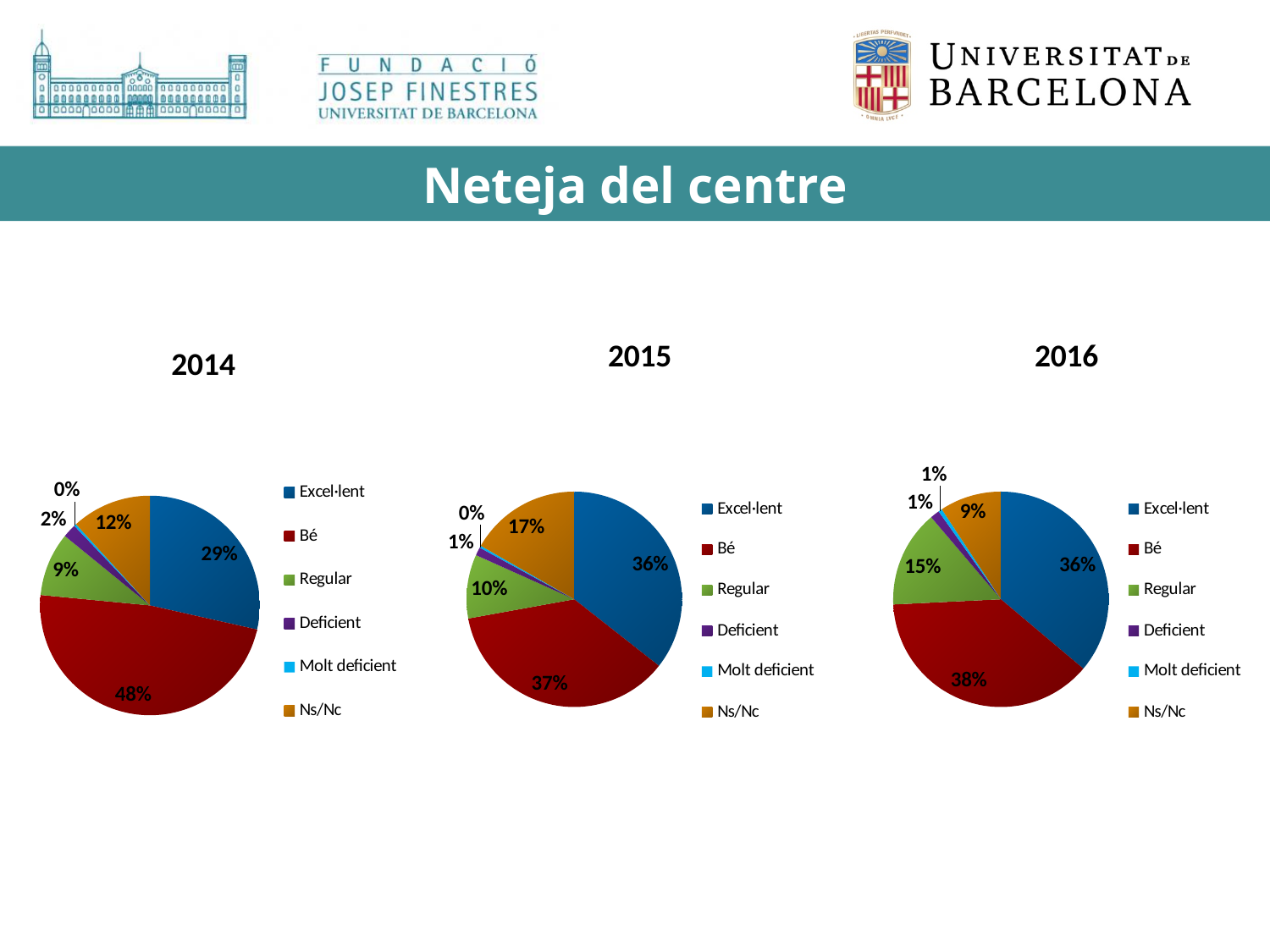
In the 2015 chart, what share of responses is Excel·lent? 36% In the 2014 chart, what share of responses is Bé? 48% In the 2014 chart, which category has the largest slice? Bé In the 2016 chart, what is the share for Bé? 38% Which is larger in the 2016 chart, the Regular slice or the Ns/Nc slice? Regular How many categories does the legend of each pie chart list? 6 In the 2016 chart, what share of responses is Regular? 15% What kind of charts are shown on the slide? Pie charts In the 2014 chart, what is the share for Ns/Nc? 12% In the 2015 chart, what is the difference between the Bé share and the Regular share? 27% In the 2015 chart, what is the share for Ns/Nc? 17% What is the title of the slide above the three pie charts? Neteja del centre